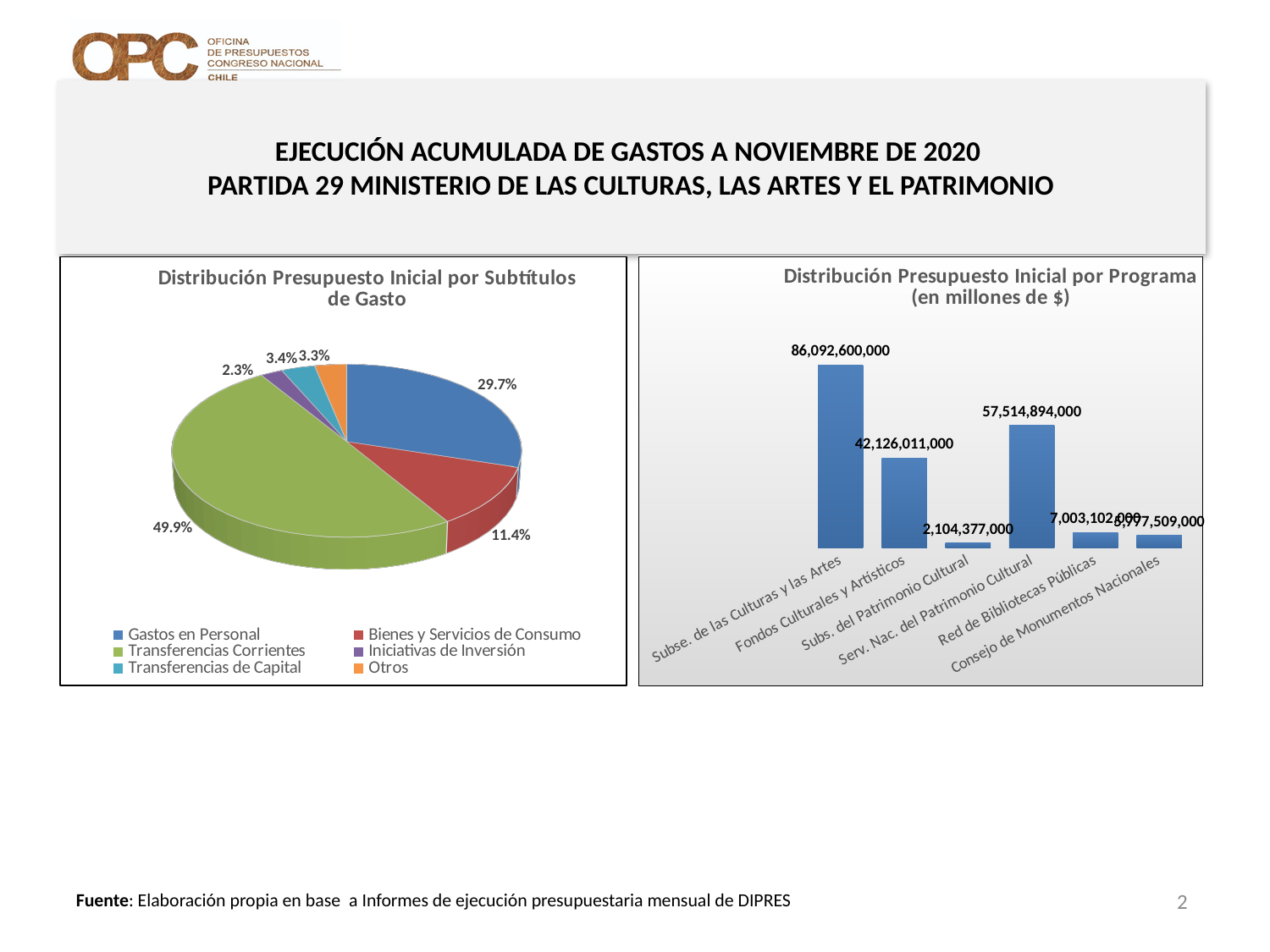
In the pie chart 'Distribución Presupuesto Inicial por Subtítulos de Gasto', what share does Transferencias Corrientes have? 49.9% In the pie chart on the left, which category has the largest slice? Transferencias Corrientes In the bar chart on the right, what is the value for Serv. Nac. del Patrimonio Cultural? 57,514,894,000 In the pie chart on the left, how many percentage points larger is Transferencias Corrientes than Gastos en Personal? 20.2% In the bar chart 'Distribución Presupuesto Inicial por Programa', what is the value for Subse. de las Culturas y las Artes? 86,092,600,000 In the bar chart on the right, which program has the lowest value? Subs. del Patrimonio Cultural In the pie chart on the left, what percentage is shown for Gastos en Personal? 29.7% In the bar chart on the right, which is larger: Fondos Culturales y Artísticos or Serv. Nac. del Patrimonio Cultural? Serv. Nac. del Patrimonio Cultural In the bar chart on the right, what is the difference between Subse. de las Culturas y las Artes and Serv. Nac. del Patrimonio Cultural? 28,577,706,000 How many entries does the legend of the pie chart on the left list? 6 What kind of chart is 'Distribución Presupuesto Inicial por Subtítulos de Gasto'? Pie chart In the pie chart on the left, which category has the smallest slice? Iniciativas de Inversión